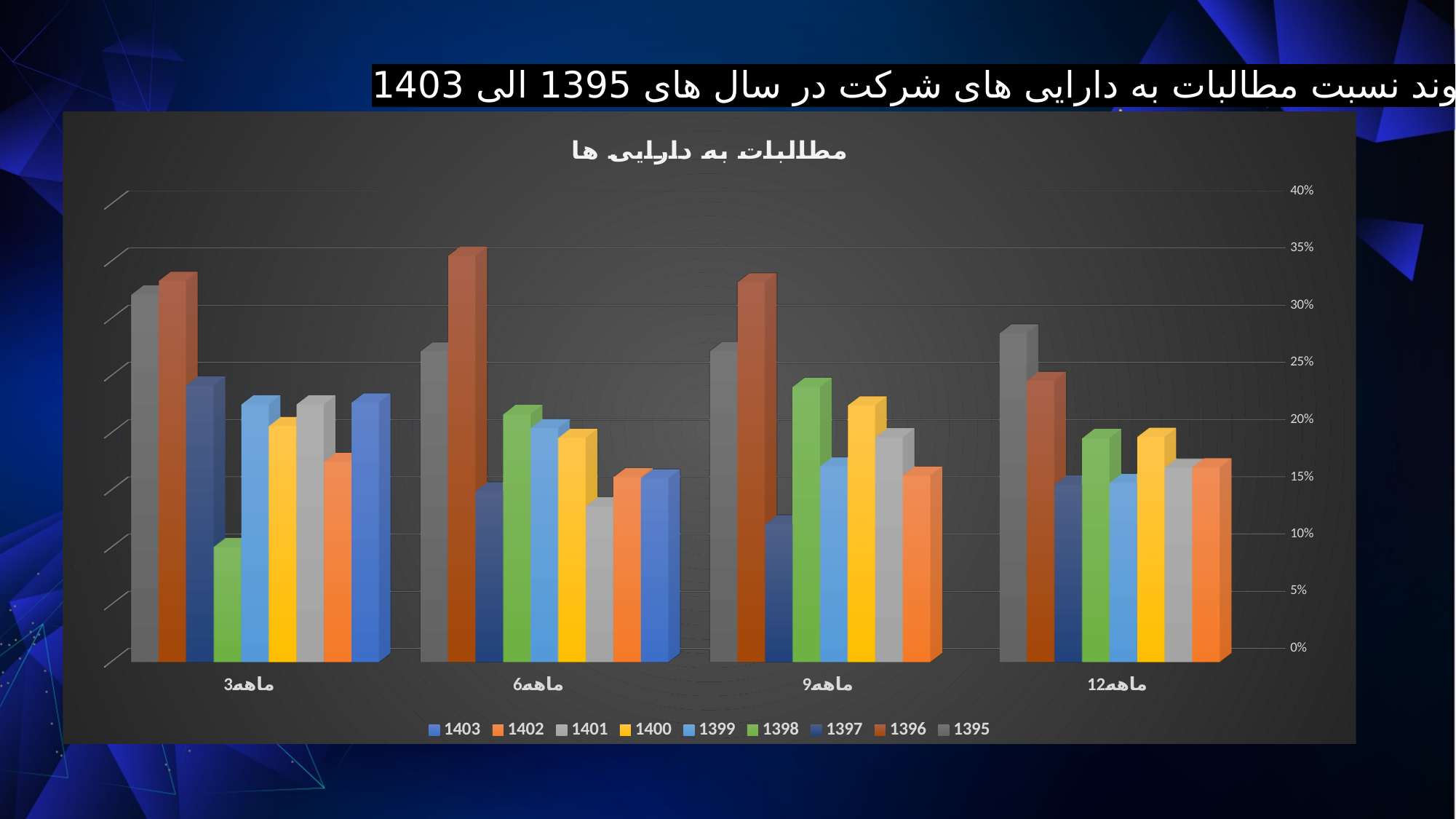
What kind of chart is shown on the slide? bar chart In the 12ماهه group, which is larger: the value for 1395 or the value for 1396? 1395 In the 6ماهه group, which year has the highest value? 1396 In the 3ماهه group, which year has the highest value? 1396 In the 3ماهه group, which year has the lowest value? 1398 In the 9ماهه group, which year has the lowest value? 1397 How many categories are shown on the x axis? 4 Is the value for 1397 in the 9ماهه group greater or less than 15%? less Is the value for 1396 in the 6ماهه group greater or less than 30%? greater How many series does the legend list? 9 Across the four groups, in which group is the 1396 bar the tallest? 6ماهه